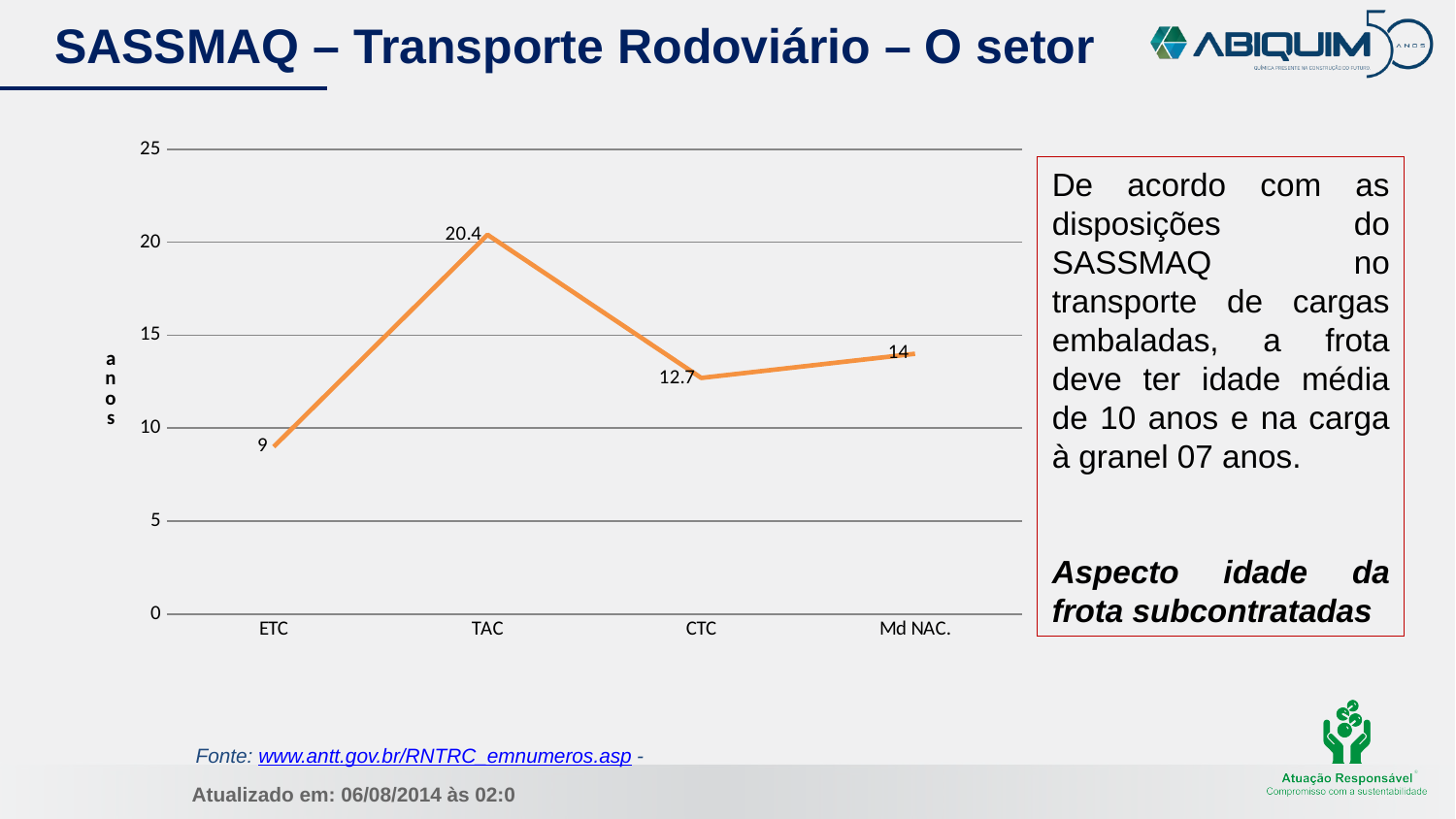
Which is larger, the value for CTC or the value for Md NAC.? Md NAC. What is the difference between the values for Md NAC. and CTC? 1.3 What is the value for Md NAC.? 14 What is the difference between the values for TAC and ETC? 11.4 Which category has the highest value? TAC What is the value for TAC? 20.4 How many categories are shown on the x axis? 4 What is the value for CTC? 12.7 What is the label on the vertical axis of the chart? anos What kind of chart is shown on the slide? line chart Which category has the lowest value? ETC What is the value for ETC? 9